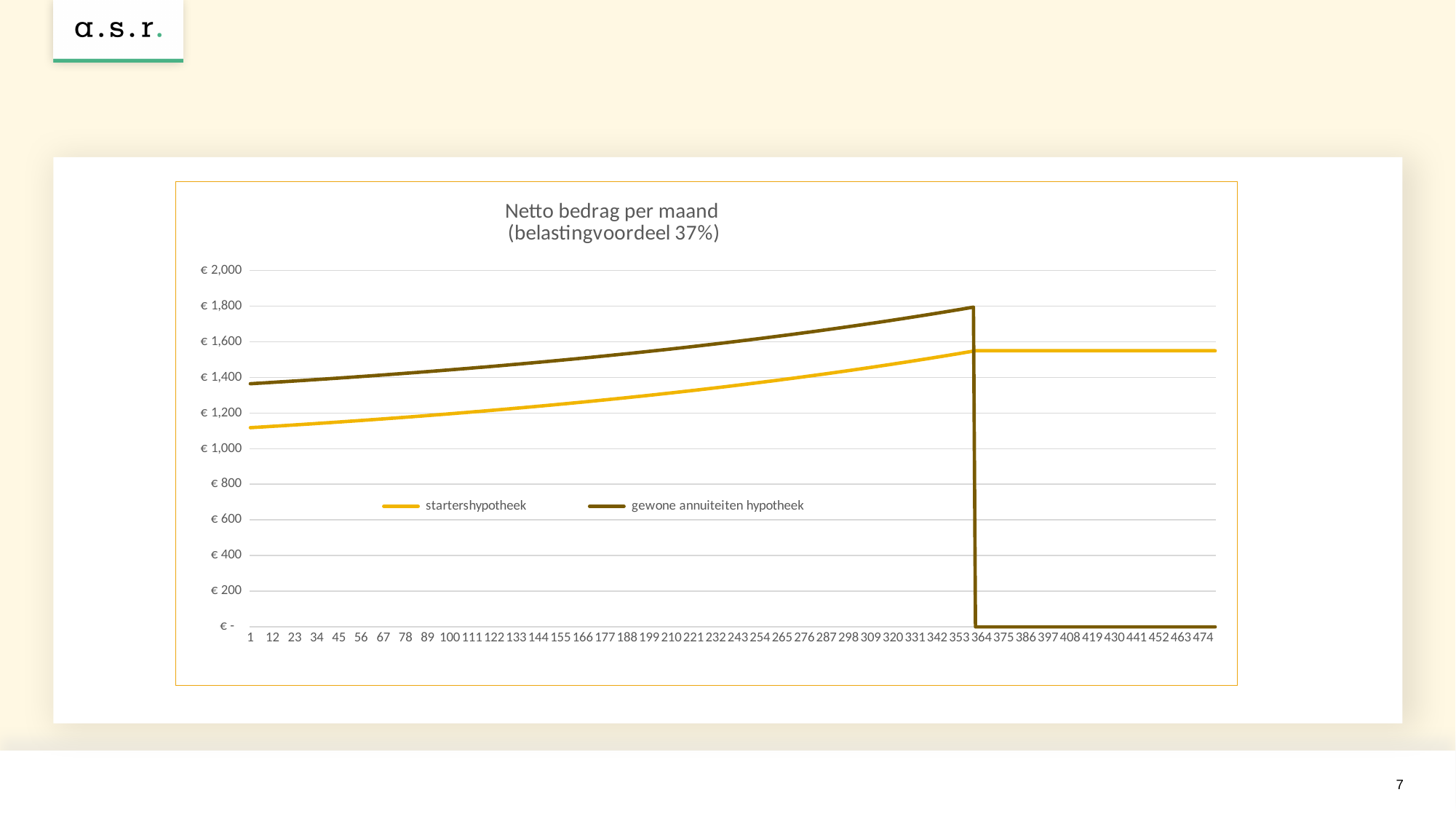
At month 1, which series has the higher value: startershypotheek or gewone annuiteiten hypotheek? gewone annuiteiten hypotheek What is the title of the chart? Netto bedrag per maand (belastingvoordeel 37%) Is the value for startershypotheek at month 474 greater or less than € 1,400? greater Which series is drawn in the dark brown line? gewone annuiteiten hypotheek Does the startershypotheek line rise or fall between month 1 and month 353? rise How many series does the legend list? 2 Is the value for startershypotheek at month 1 greater or less than € 1,000? greater Is the value for gewone annuiteiten hypotheek at month 474 greater or less than € 200? less What kind of chart is shown on the slide? line chart At month 474, which series has the higher value: startershypotheek or gewone annuiteiten hypotheek? startershypotheek